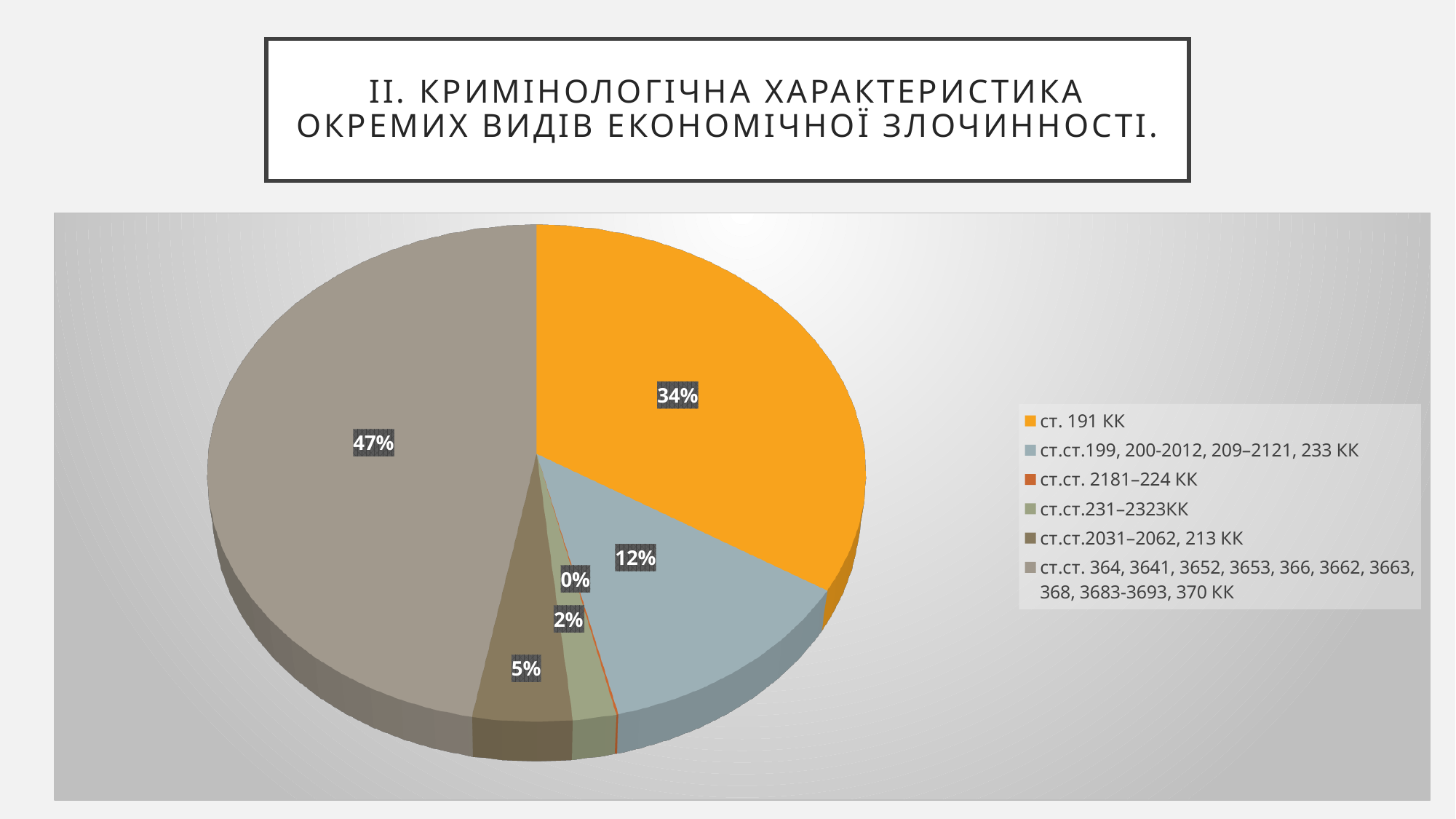
What kind of chart is shown on the slide? pie chart Which category has the largest slice of the pie? ст.ст. 364, 3641, 3652, 3653, 366, 3662, 3663, 368, 3683-3693, 370 КК What share of the pie does the slice for ст.ст. 364, 3641, 3652, 3653, 366, 3662, 3663, 368, 3683-3693, 370 КК represent? 47% What is the value shown for ст.ст.199, 200-2012, 209–2121, 233 КК? 12% Which category has the smallest slice of the pie? ст.ст. 2181–224 КК How many categories does the legend of the pie chart list? 6 What is the value shown for ст.ст.231–2323КК? 2% What share of the pie does the slice for ст. 191 КК represent? 34% Which is larger: the slice for ст.ст.2031–2062, 213 КК or the slice for ст.ст.231–2323КК? ст.ст.2031–2062, 213 КК What is the value shown for ст.ст.2031–2062, 213 КК? 5% What is the difference in percentage points between the slice for ст.ст. 364, 3641, 3652, 3653, 366, 3662, 3663, 368, 3683-3693, 370 КК and the slice for ст. 191 КК? 13% What is the value shown for ст.ст. 2181–224 КК? 0%